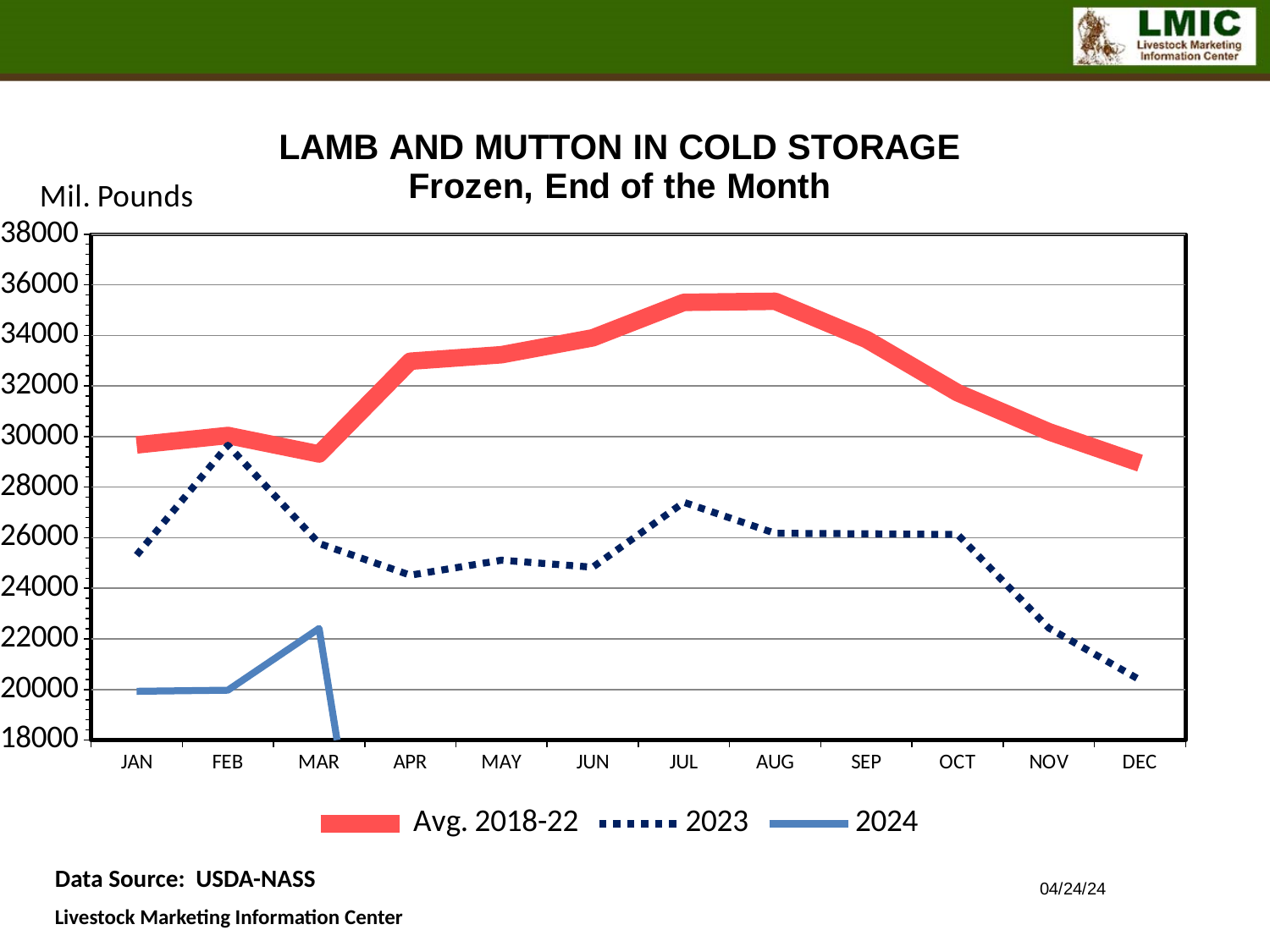
Is the 2023 value for JAN greater or less than 26000? less How many months are shown along the x axis? 12 What kind of chart is shown on the slide? line chart In which month does the 2023 series reach its highest value? FEB How many series does the legend list? 3 Is the 2023 value for JUL greater or less than 26000? greater Which series has the larger value in JAN, Avg. 2018-22 or 2023? Avg. 2018-22 In which month does the 2023 series reach its lowest value? DEC Is the Avg. 2018-22 value for APR greater or less than 32000? greater Does the Avg. 2018-22 series rise or fall from AUG to DEC? fall What unit label is shown above the y axis? Mil. Pounds